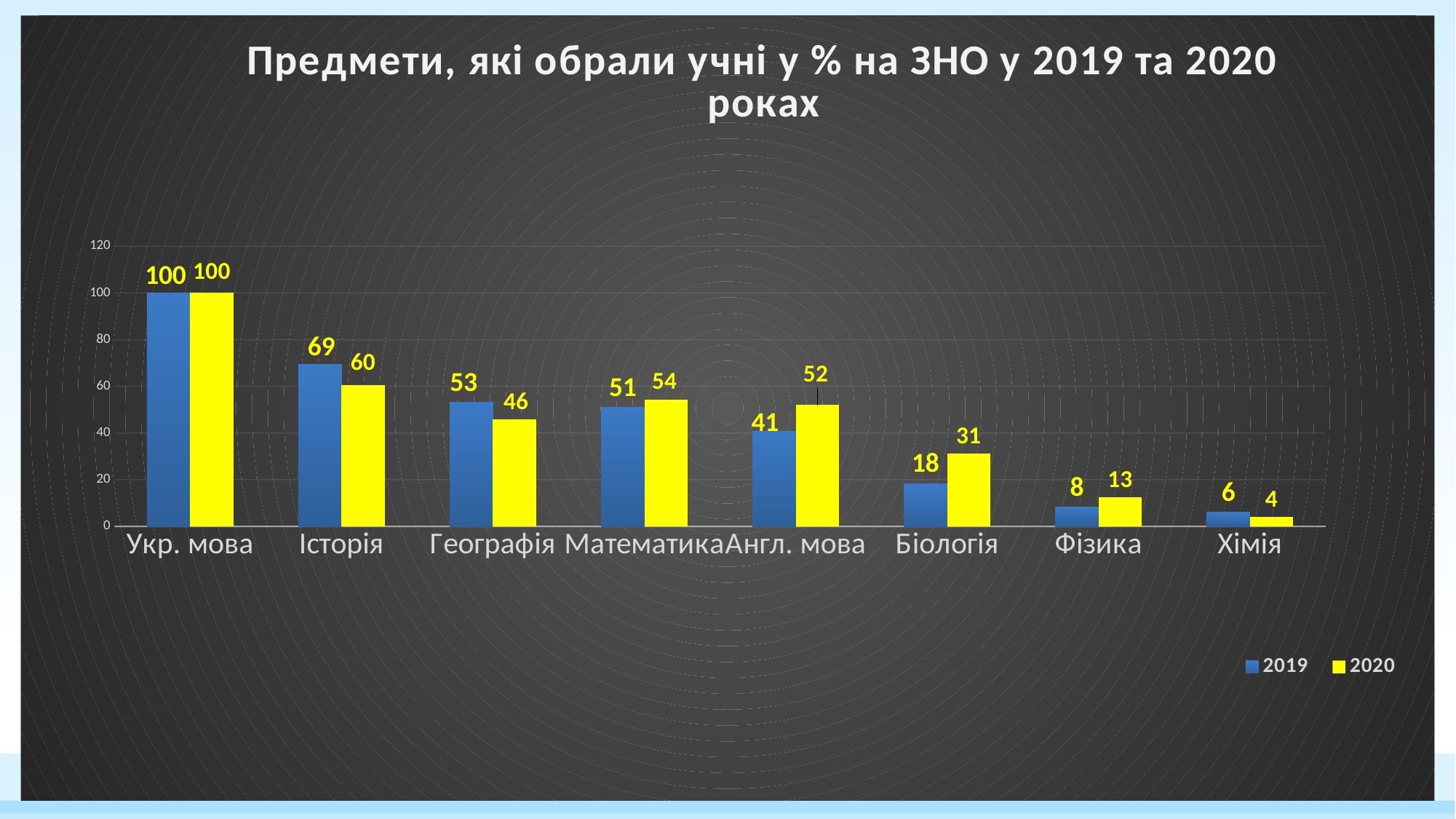
Which category has the highest value in the 2019 series? Укр. мова Which is larger for Математика: the 2019 value or the 2020 value? 2020 How many series does the legend list? 2 What is the difference between the 2020 values for Біологія and Фізика? 18 What kind of chart is shown on the slide? Bar chart What is the difference between the 2019 and 2020 values for Історія? 9 How many categories are shown on the x axis? 8 What is the value for Біологія in the 2020 series? 31 Which category has the lowest value in the 2020 series? Хімія What is the value for Історія in the 2019 series? 69 What is the value for Англ. мова in the 2019 series? 41 Which colour represents the 2020 series? Yellow